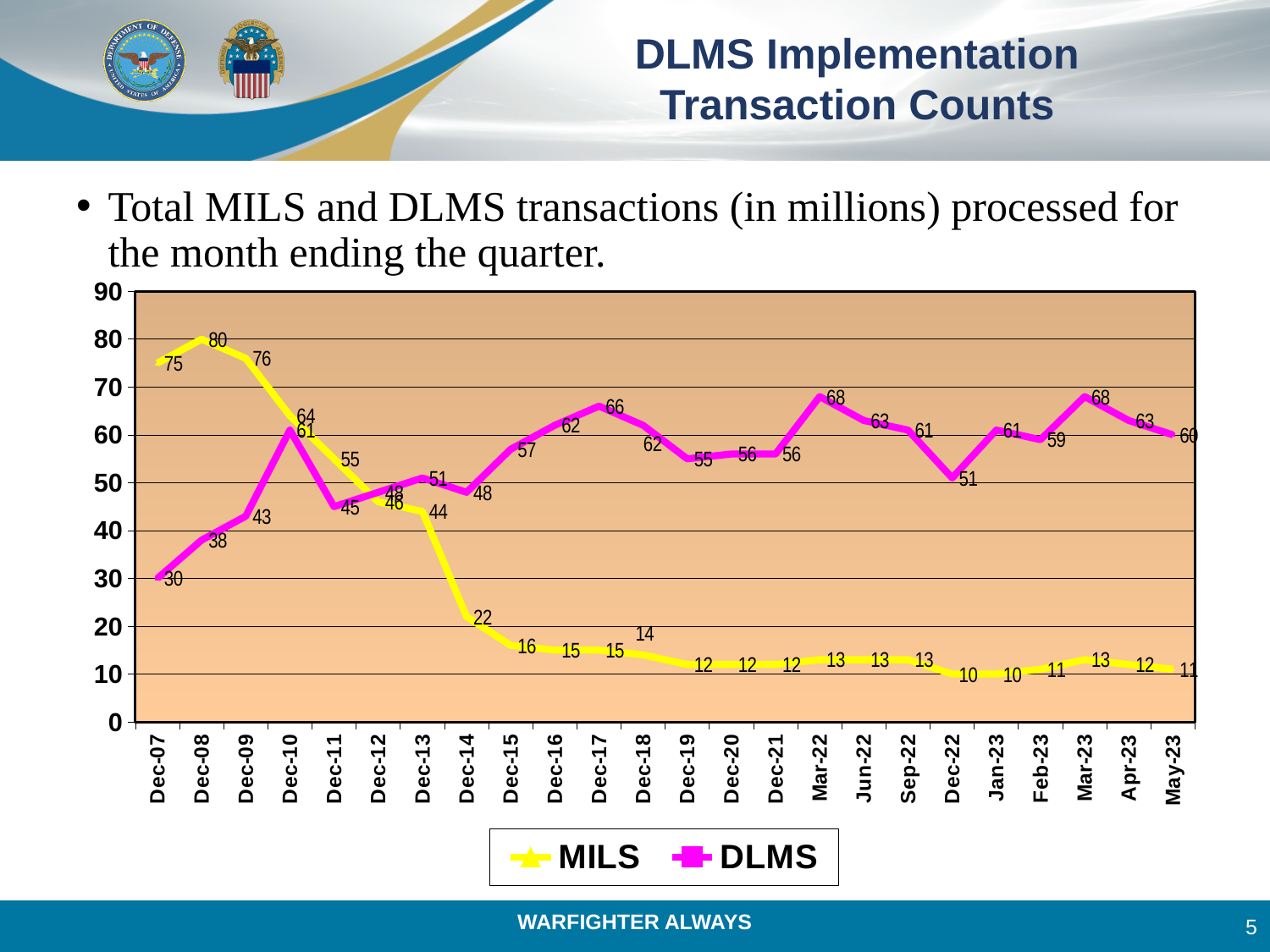
What is the DLMS value for May-23? 60 Does the MILS series generally rise or fall from Dec-08 to May-23? Fall How many series does the legend list? 2 How many periods are shown on the x axis? 24 What kind of chart is shown on the slide? Line chart What is the DLMS value for Dec-07? 30 By how much does the DLMS value in Mar-22 exceed the DLMS value in Dec-22? 17 What is the difference between the MILS and DLMS values in Dec-08? 42 In which period does the MILS series reach its highest value? Dec-08 In Dec-10, which series has the larger value, MILS or DLMS? MILS In which period is the DLMS series at its lowest value? Dec-07 What is the MILS value for Dec-07? 75